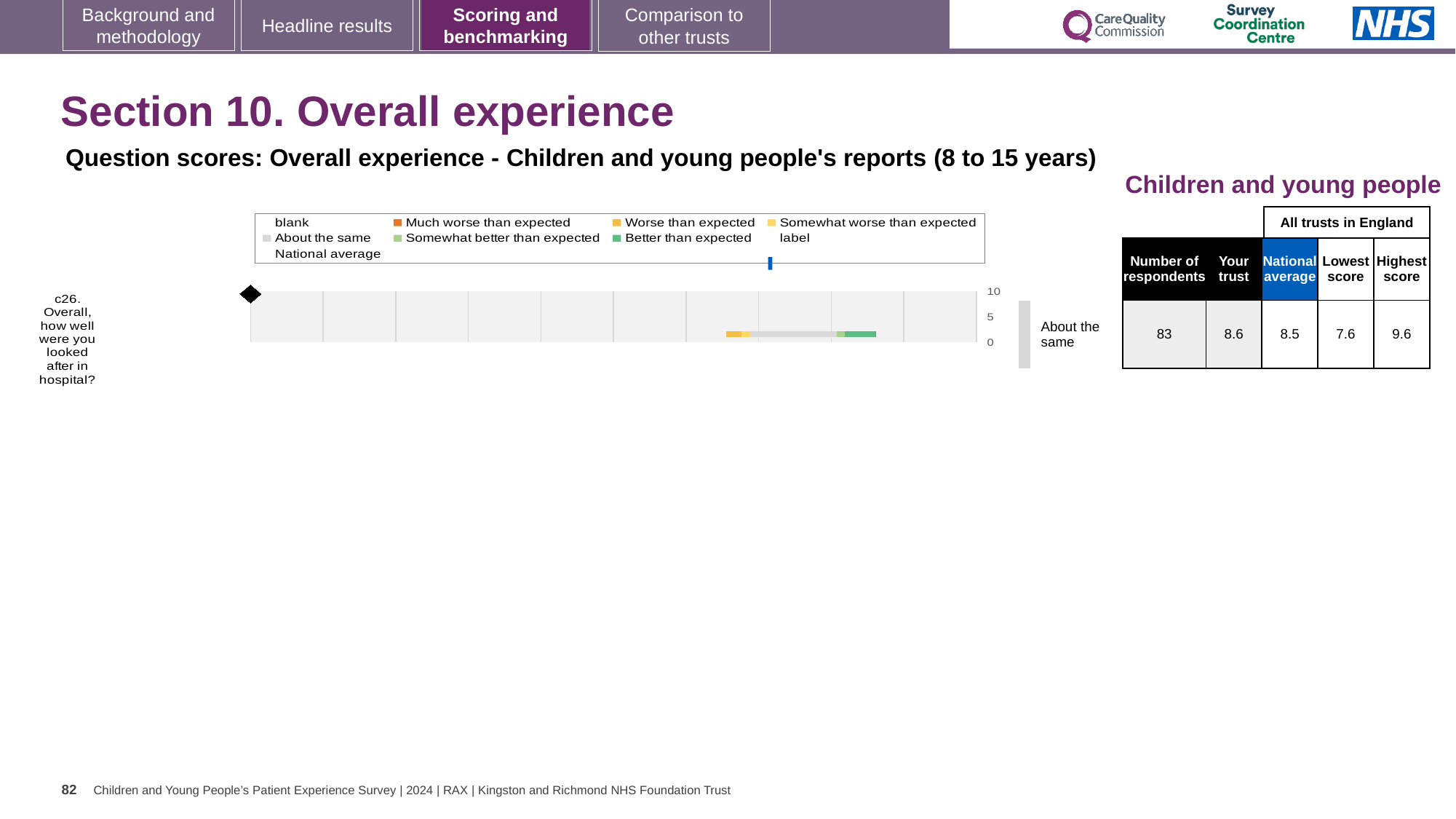
What is the national average score shown for c26? 8.5 How many respondents answered question c26? 83 What is the difference between the highest score and the lowest score for c26? 2.0 By how much does the 'Your trust' score exceed the national average for c26? 0.1 What is the highest tick value shown on the chart's score axis? 10 What is the highest score among all trusts in England for c26? 9.6 What is the lowest score among all trusts in England for c26? 7.6 According to the table next to the chart, what is the 'Your trust' score for c26 'Overall, how well were you looked after in hospital?'? 8.6 What kind of chart is used to show the question score for c26? bar chart Which is larger for c26: the 'Your trust' score or the national average? Your trust What benchmark category label is shown to the right of the bar for c26? About the same How many survey questions are plotted on the chart? 1